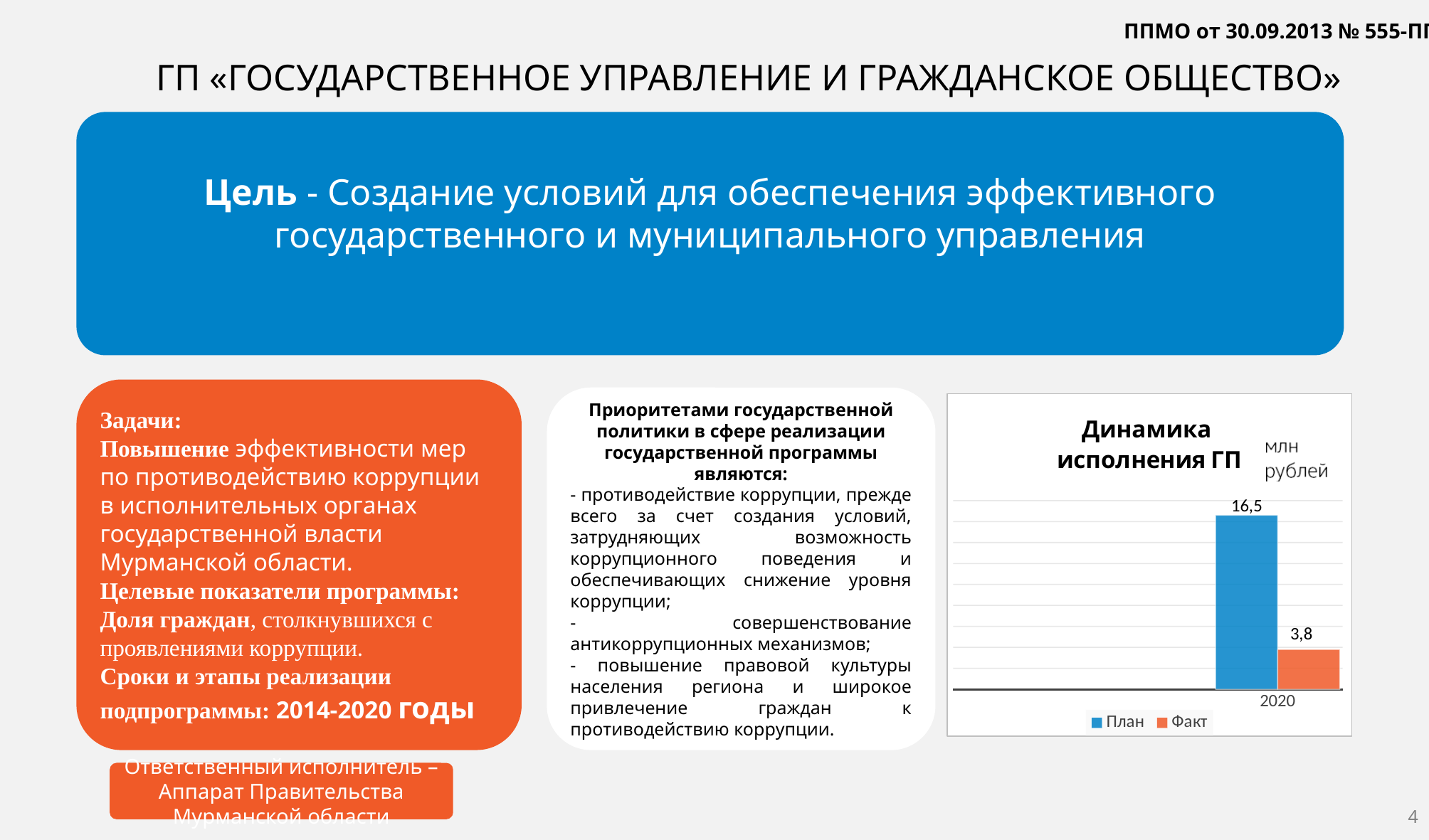
Which series has the lowest value in the chart? Факт What is the difference between План and Факт for 2020? 12,7 What is the value of План for 2020? 16,5 Which series has the higher value for 2020, План or Факт? План Which series has the highest value in the chart? План How many series does the legend list? 2 How many categories are shown on the x axis? 1 What is the value of Факт for 2020? 3,8 What unit is indicated next to the chart title? млн рублей What is the title of the chart? Динамика исполнения ГП Which year is shown on the x axis of the chart? 2020 What kind of chart is shown on the slide? bar chart